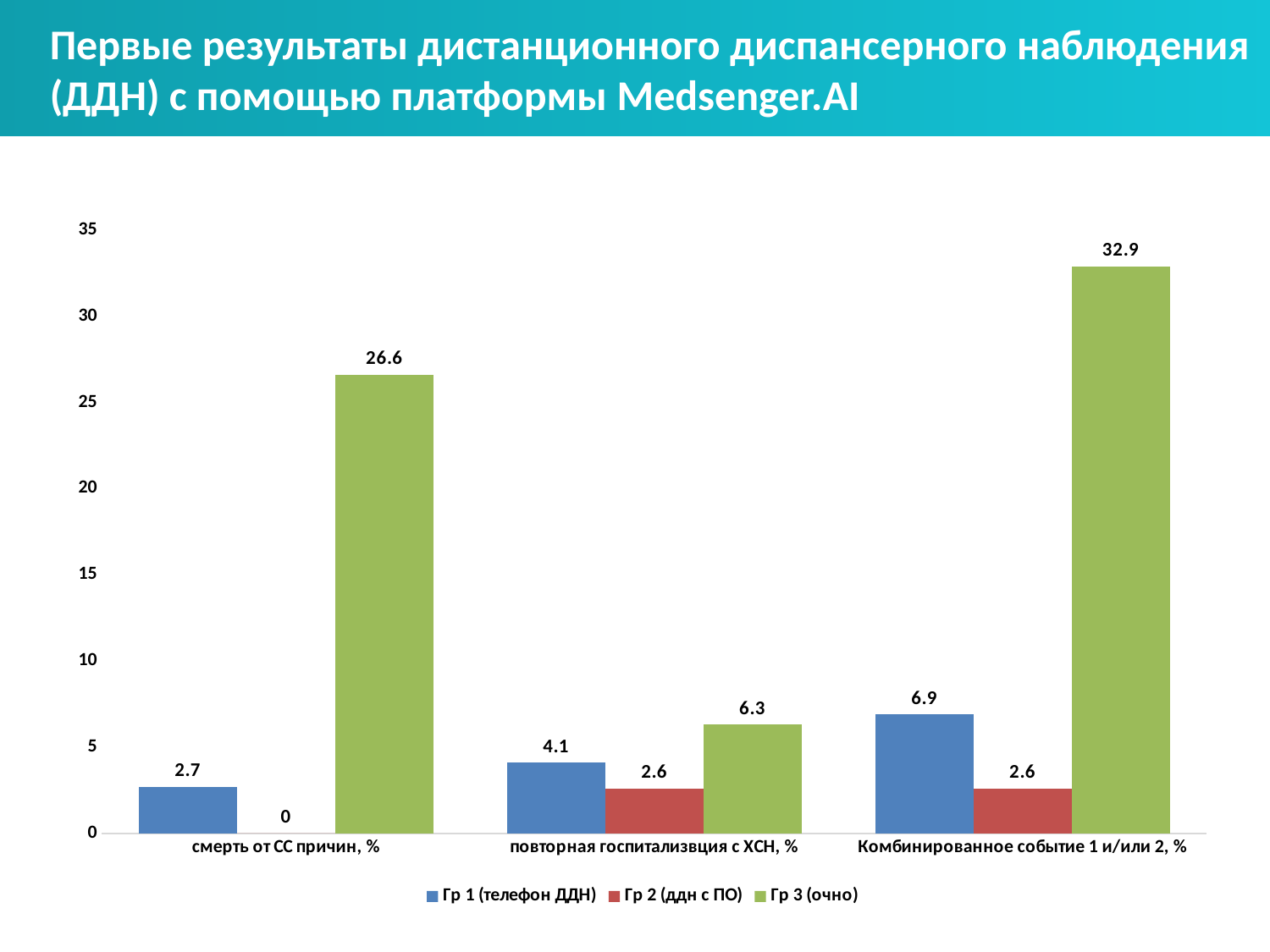
How many categories are shown on the x axis? 3 In the category 'повторная госпитализвция с ХСН, %', which is larger: Гр 1 (телефон ДДН) or Гр 2 (ддн с ПО)? Гр 1 (телефон ДДН) Is the value for Гр 3 (очно) in 'Комбинированное событие 1 и/или 2, %' greater or less than 30? greater How many series does the legend list? 3 What kind of chart is shown on the slide? bar chart What is the value for Гр 2 (ддн с ПО) in the category 'смерть от СС причин, %'? 0 What is the value for Гр 3 (очно) in the category 'смерть от СС причин, %'? 26.6 Which category has the highest value for Гр 3 (очно)? Комбинированное событие 1 и/или 2, % Which category has the lowest value for Гр 1 (телефон ДДН)? смерть от СС причин, % What is the value for Гр 1 (телефон ДДН) in the category 'повторная госпитализвция с ХСН, %'? 4.1 What colour are the bars for Гр 3 (очно)? green What is the difference between Гр 3 (очно) and Гр 1 (телефон ДДН) in the category 'Комбинированное событие 1 и/или 2, %'? 26